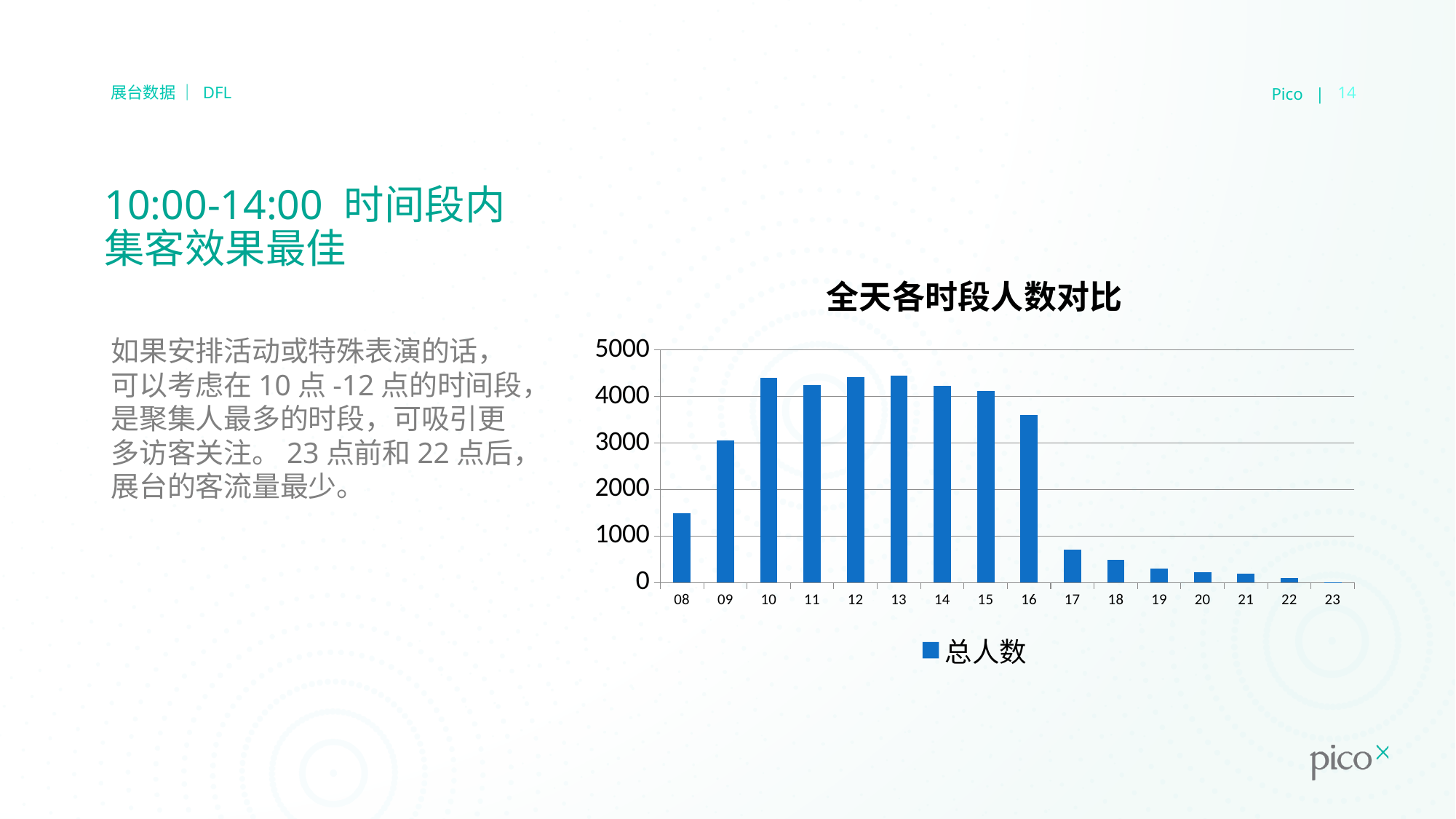
Is the value for 16 greater or less than 3000? greater Is the value for 09 greater or less than 4000? less Which time slot has the lowest value? 23 Is the value for 08 greater or less than 1000? greater What kind of chart is shown on the slide? bar chart How many series does the legend list? 1 How many time-slot categories are shown on the x axis? 16 Which has the larger value, 09 or 16? 16 What is the name of the series shown in the legend? 总人数 Do the values rise or fall from 16 to 23 along the x axis? fall What is the title of the chart? 全天各时段人数对比